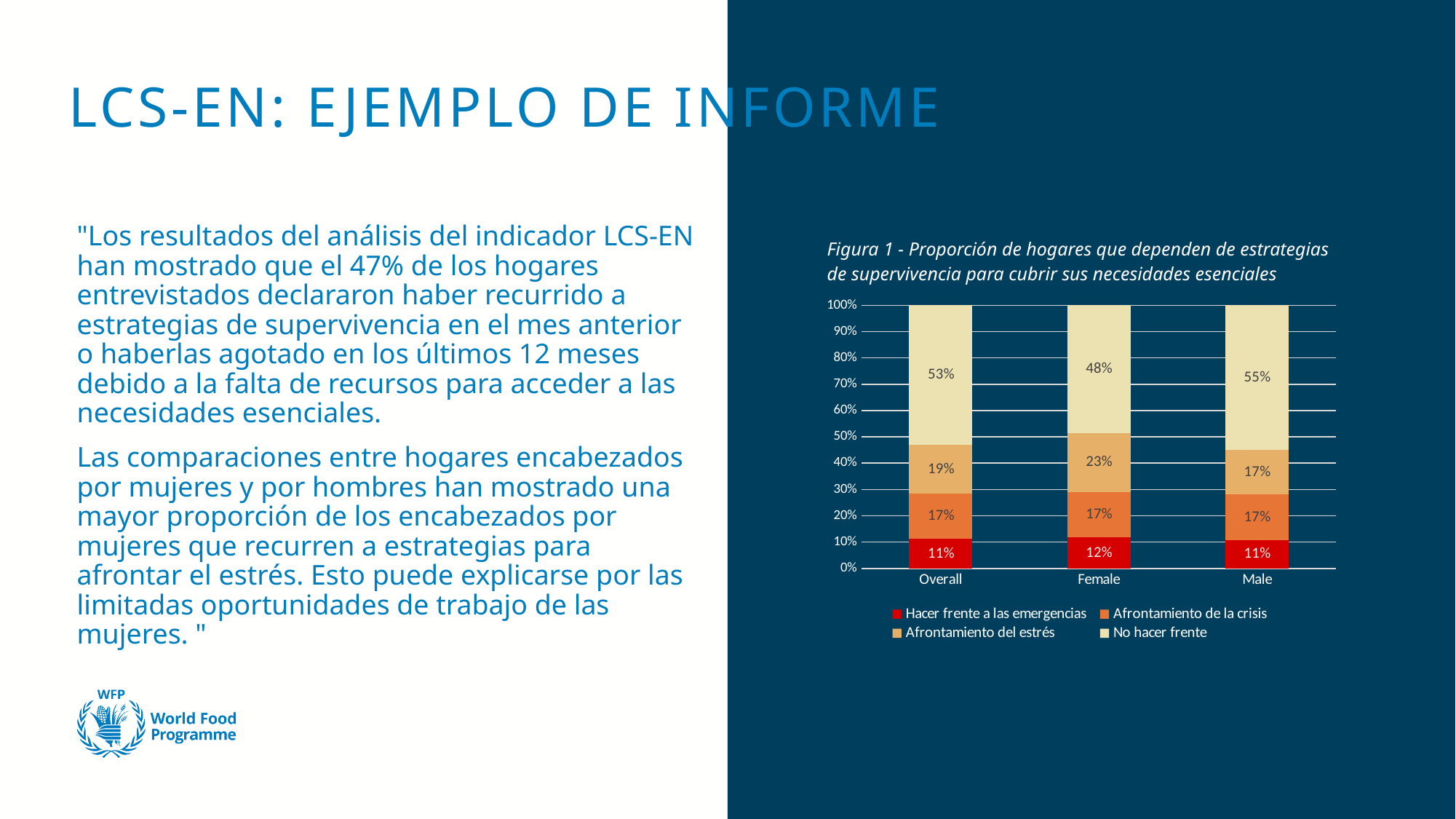
What kind of chart is shown on the slide? Stacked bar chart What is the value of 'Afrontamiento del estrés' for Male? 17% What is the value of 'Afrontamiento de la crisis' for Female? 17% Which category has the highest value for 'No hacer frente'? Male What is the value of 'No hacer frente' for Female? 48% What is the title of the figure shown on the slide? Figura 1 - Proporción de hogares que dependen de estrategias de supervivencia para cubrir sus necesidades esenciales How many categories are shown on the x axis of the chart? 3 What is the difference between the 'Afrontamiento del estrés' values for Female and Male? 6% Which category has the lowest value for 'Afrontamiento del estrés'? Male What is the value of 'Hacer frente a las emergencias' for Overall? 11% Which is larger: 'No hacer frente' for Overall or for Female? Overall How many series does the chart legend list? 4